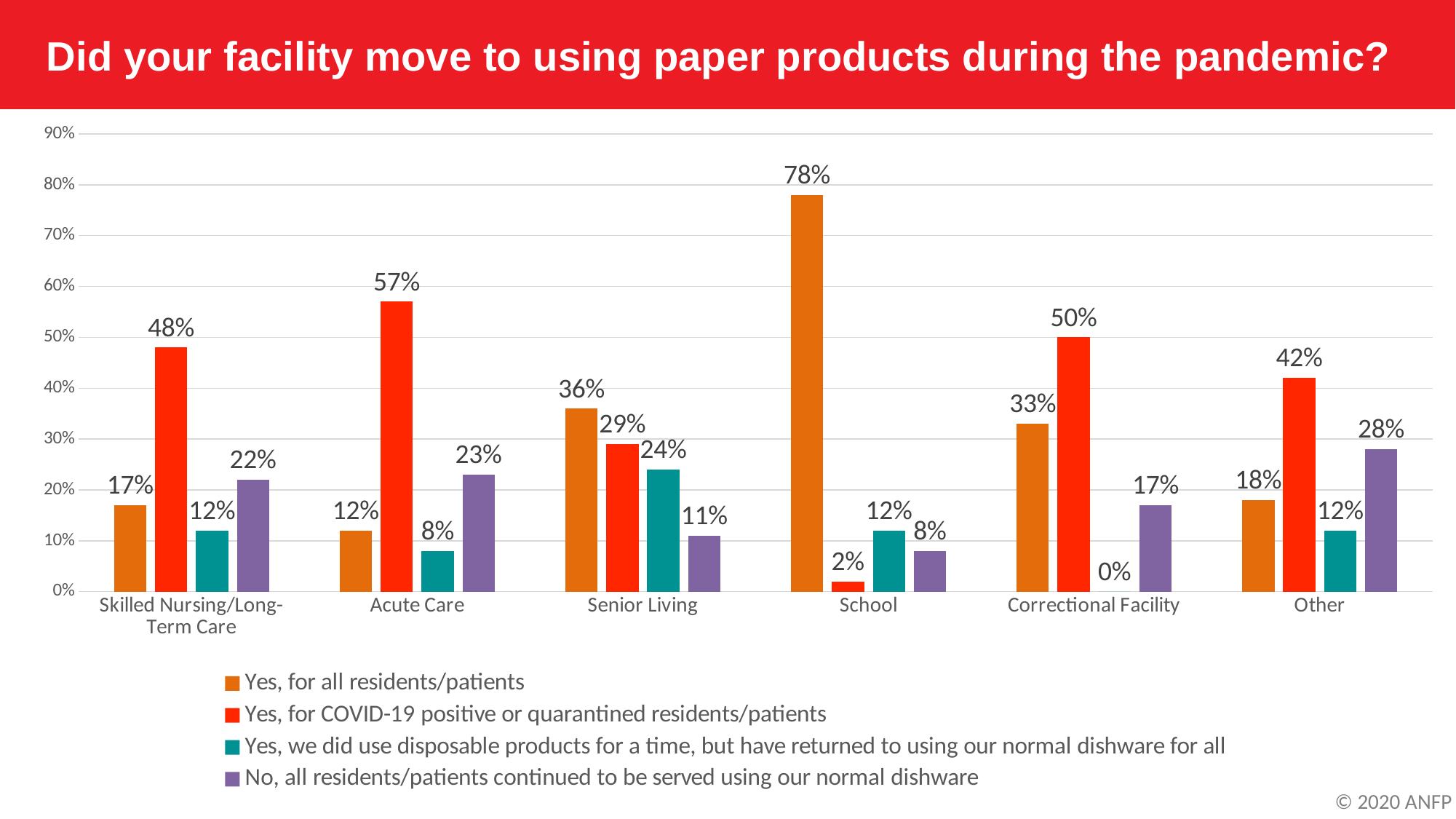
What percentage of School facilities answered "Yes, for all residents/patients"? 78% What is the title of the chart? Did your facility move to using paper products during the pandemic? How many facility types are shown on the x axis? 6 What is the value for Acute Care in the "Yes, for COVID-19 positive or quarantined residents/patients" series? 57% Which is larger for Senior Living: "Yes, for all residents/patients" or "Yes, for COVID-19 positive or quarantined residents/patients"? Yes, for all residents/patients What is the value for Correctional Facility in the "Yes, we did use disposable products for a time, but have returned to using our normal dishware for all" series? 0% Which facility type has the highest value in the "Yes, for all residents/patients" series? School Which facility type has the lowest value in the "Yes, for COVID-19 positive or quarantined residents/patients" series? School How many series does the legend list? 4 What is the difference between the "Yes, for COVID-19 positive or quarantined residents/patients" value for Acute Care and for Skilled Nursing/Long-Term Care? 9% What percentage of Correctional Facility respondents said "No, all residents/patients continued to be served using our normal dishware"? 17% What kind of chart is shown on the slide? Bar chart